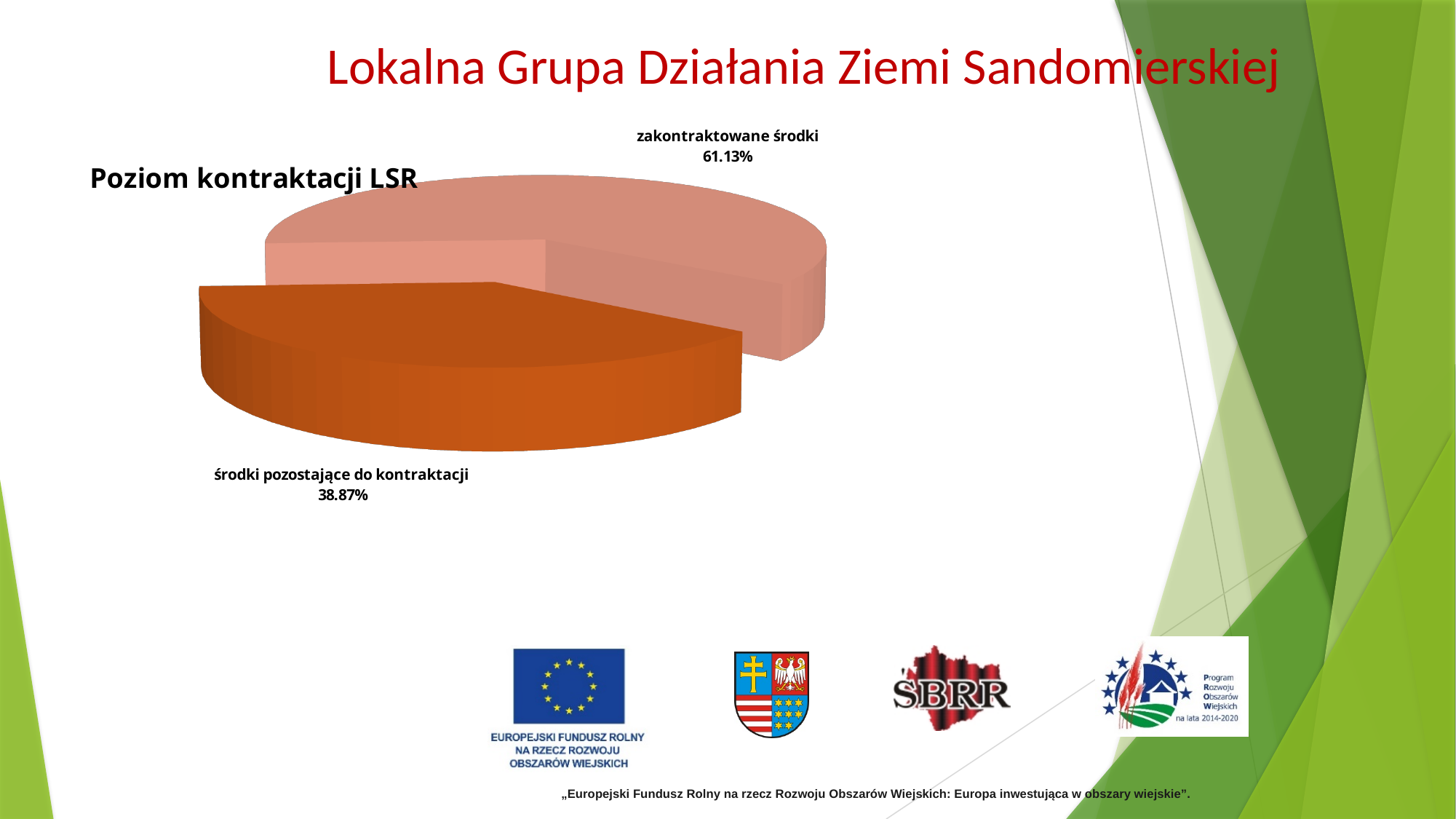
What colour is the 'środki pozostające do kontraktacji' slice? orange What percentage does the 'zakontraktowane środki' slice represent? 61.13% What kind of chart is shown on the slide? pie chart Which slice is the smallest in the pie chart? środki pozostające do kontraktacji How many slices does the pie chart have? 2 Which slice is the largest in the pie chart? zakontraktowane środki What percentage does the 'środki pozostające do kontraktacji' slice represent? 38.87% Which is larger: 'zakontraktowane środki' or 'środki pozostające do kontraktacji'? zakontraktowane środki Is the share of 'zakontraktowane środki' greater or less than 50%? greater What is the difference in percentage points between 'zakontraktowane środki' and 'środki pozostające do kontraktacji'? 22.26% What is the title of the chart? Poziom kontraktacji LSR